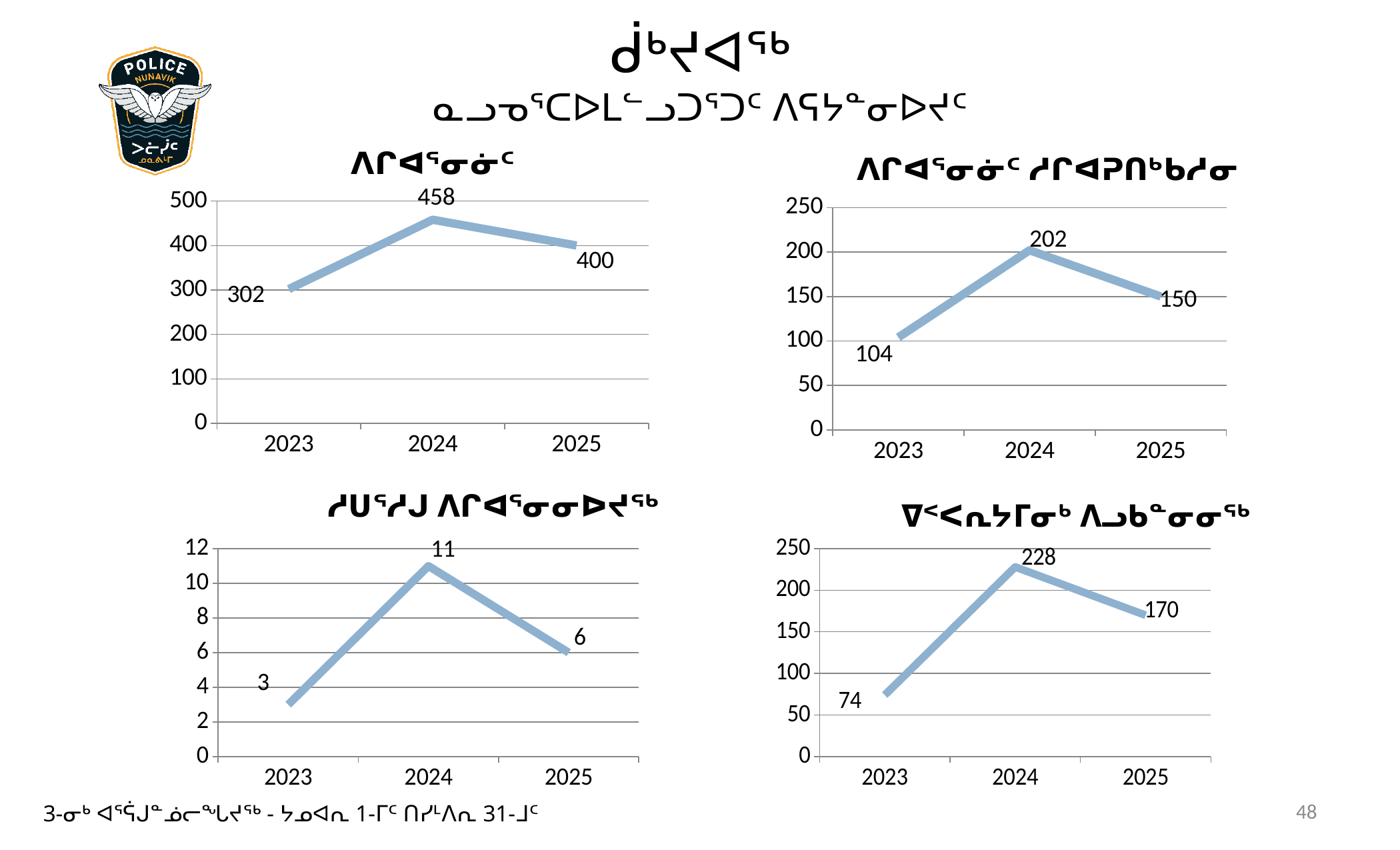
What kind of chart is the top-left chart? line chart In the bottom-left chart, what is the difference between the 2024 and 2023 values? 8 In the bottom-left chart, what is the value for 2025? 6 In the top-left chart, what is the value for 2024? 458 In the top-left chart, what is the difference between the 2024 and 2025 values? 58 In the bottom-right chart, what is the value for 2024? 228 In the top-right chart, which year has the highest value? 2024 In the bottom-right chart, does the value rise or fall from 2024 to 2025? fall In the top-right chart, is the value for 2025 larger or smaller than the value for 2023? larger In the top-left chart, which year has the lowest value? 2023 In the top-right chart, what is the value for 2023? 104 How many years are plotted on the x axis of the bottom-right chart? 3